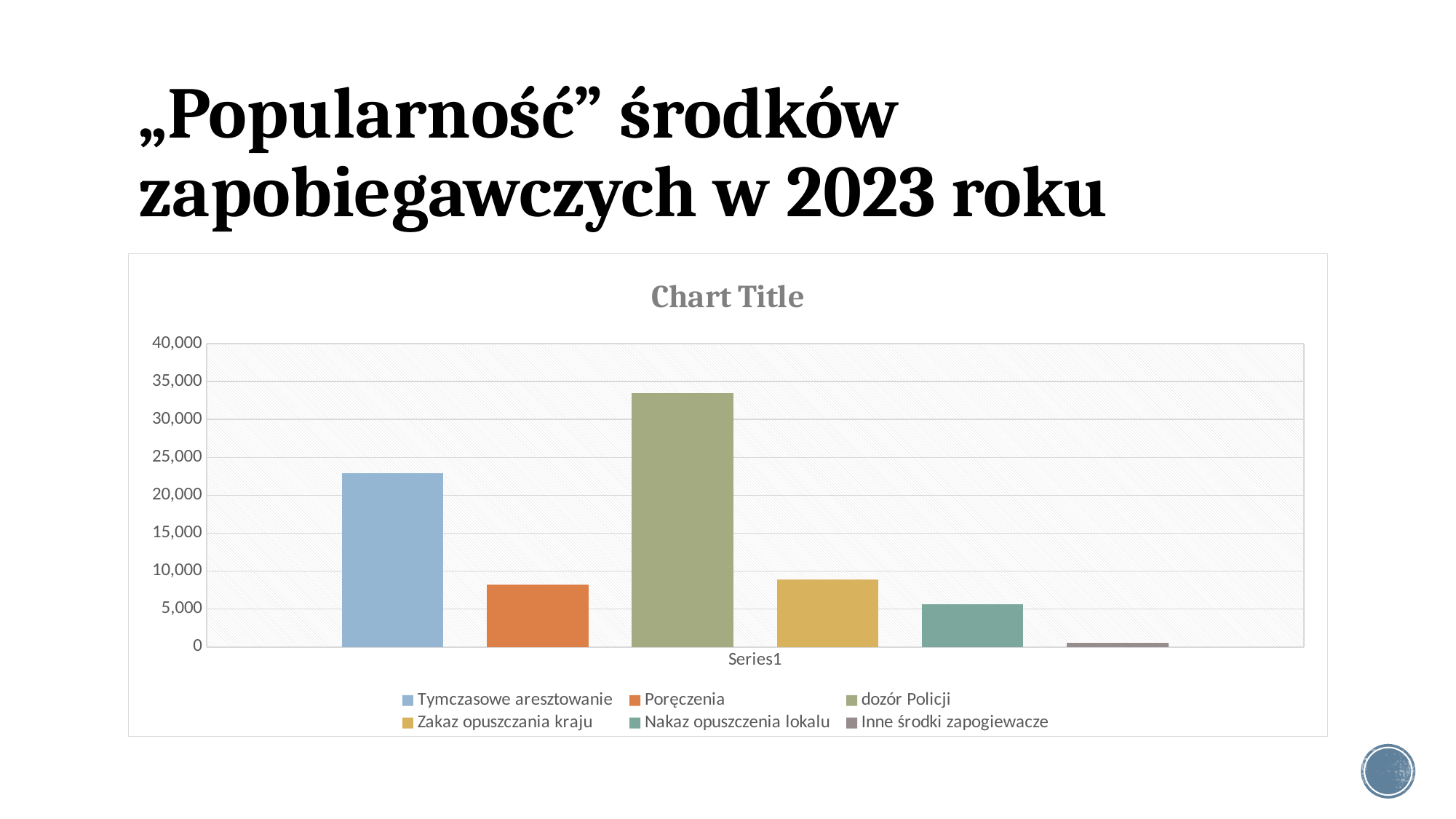
Which is larger, the value for Poręczenia or the value for Nakaz opuszczenia lokalu? Poręczenia Is the value for Tymczasowe aresztowanie greater or less than 20,000? greater How many bars are plotted in the chart? 6 Which is larger, the value for Tymczasowe aresztowanie or the value for dozór Policji? dozór Policji Is the value for Inne środki zapogiewacze greater or less than 5,000? less How many entries does the chart legend list? 6 What is the title shown above the chart? Chart Title Is the value for Poręczenia greater or less than 10,000? less Which category has the lowest bar in the chart? Inne środki zapogiewacze What kind of chart is shown on the slide? bar chart Which category has the highest bar in the chart? dozór Policji